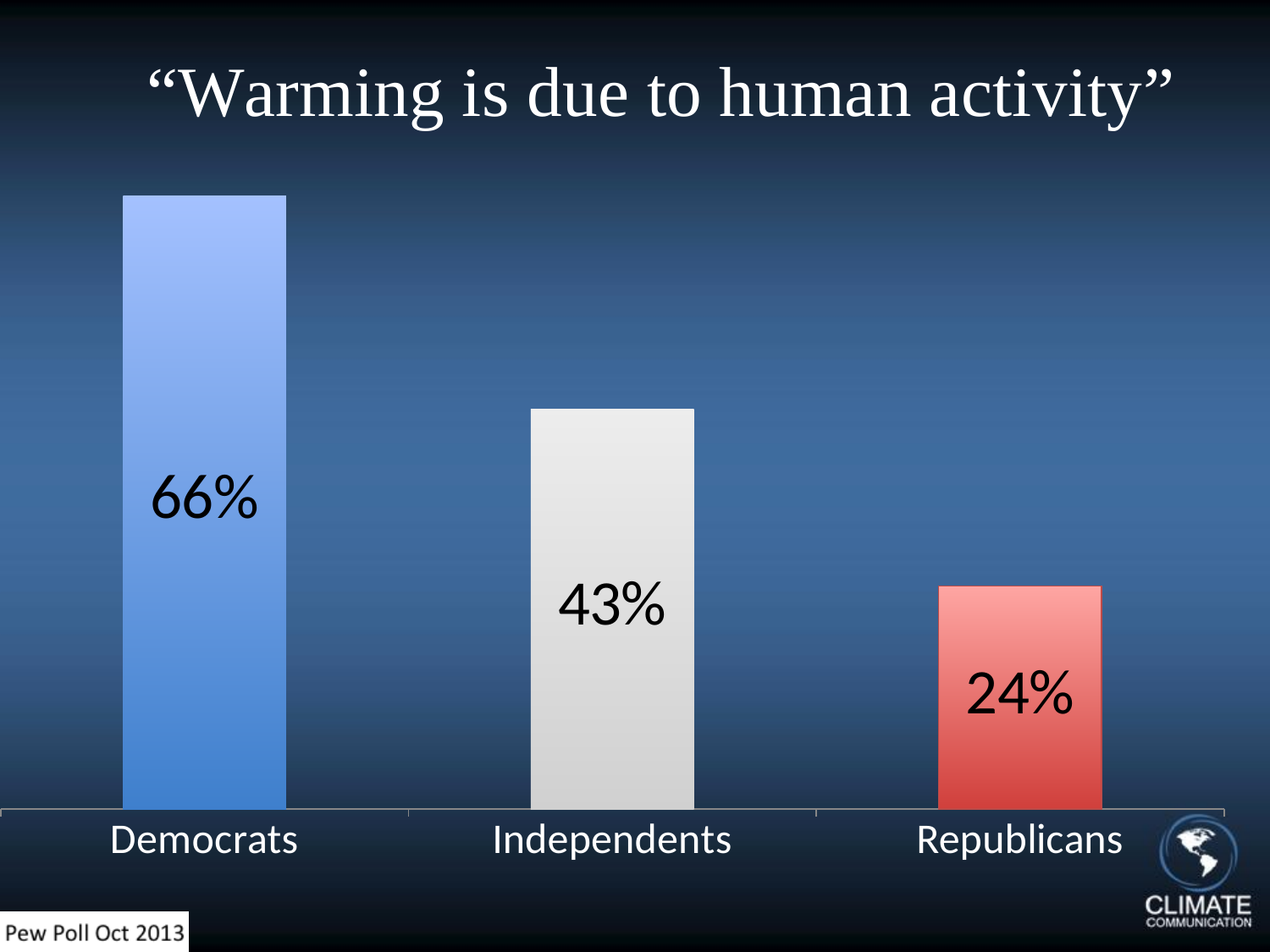
What is the difference between the values for Democrats and Republicans? 42% Which is larger, the value for Independents or the value for Republicans? Independents What kind of chart is shown on the slide? Bar chart What percentage of Democrats say warming is due to human activity? 66% What is the difference between the values for Independents and Republicans? 19% Which group has the lowest value? Republicans How many groups are shown in the chart? 3 Do the values rise or fall from left to right across the groups? Fall What is the value shown for Independents? 43% Which group has the highest value? Democrats What is the title of the chart? "Warming is due to human activity" What is the value shown for Republicans? 24%